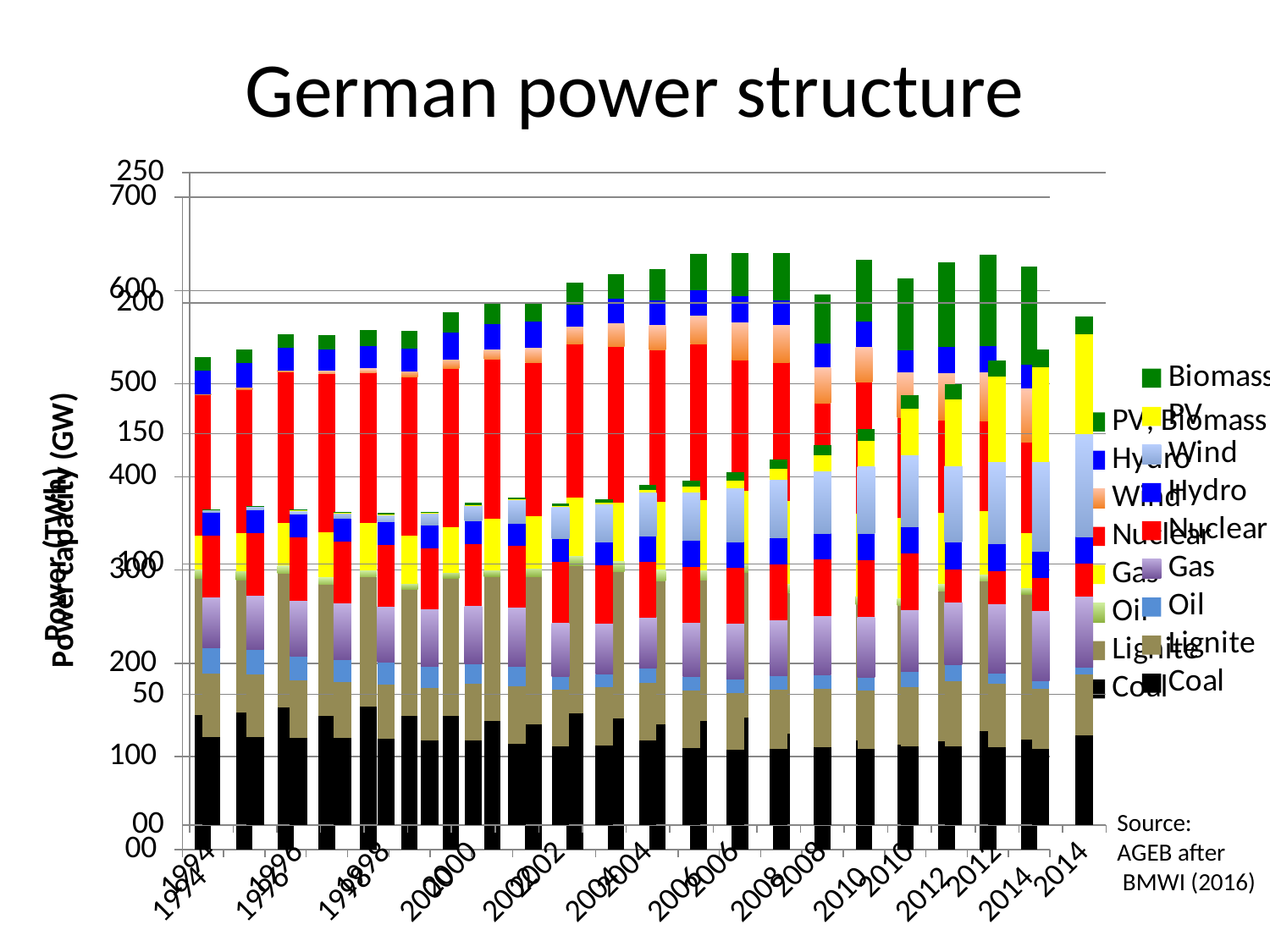
How many years (bars) are plotted along the x axis from 1994 to 2014? 21 Does the yellow PV segment grow or shrink between 2008 and 2014? Grow What kind of chart is shown on the slide? Stacked bar chart What is the title of the chart on the slide? German power structure Is the red Nuclear segment larger in the 1994 bar or in the 2014 bar? 1994 Which series is listed at the bottom of the legend? Coal